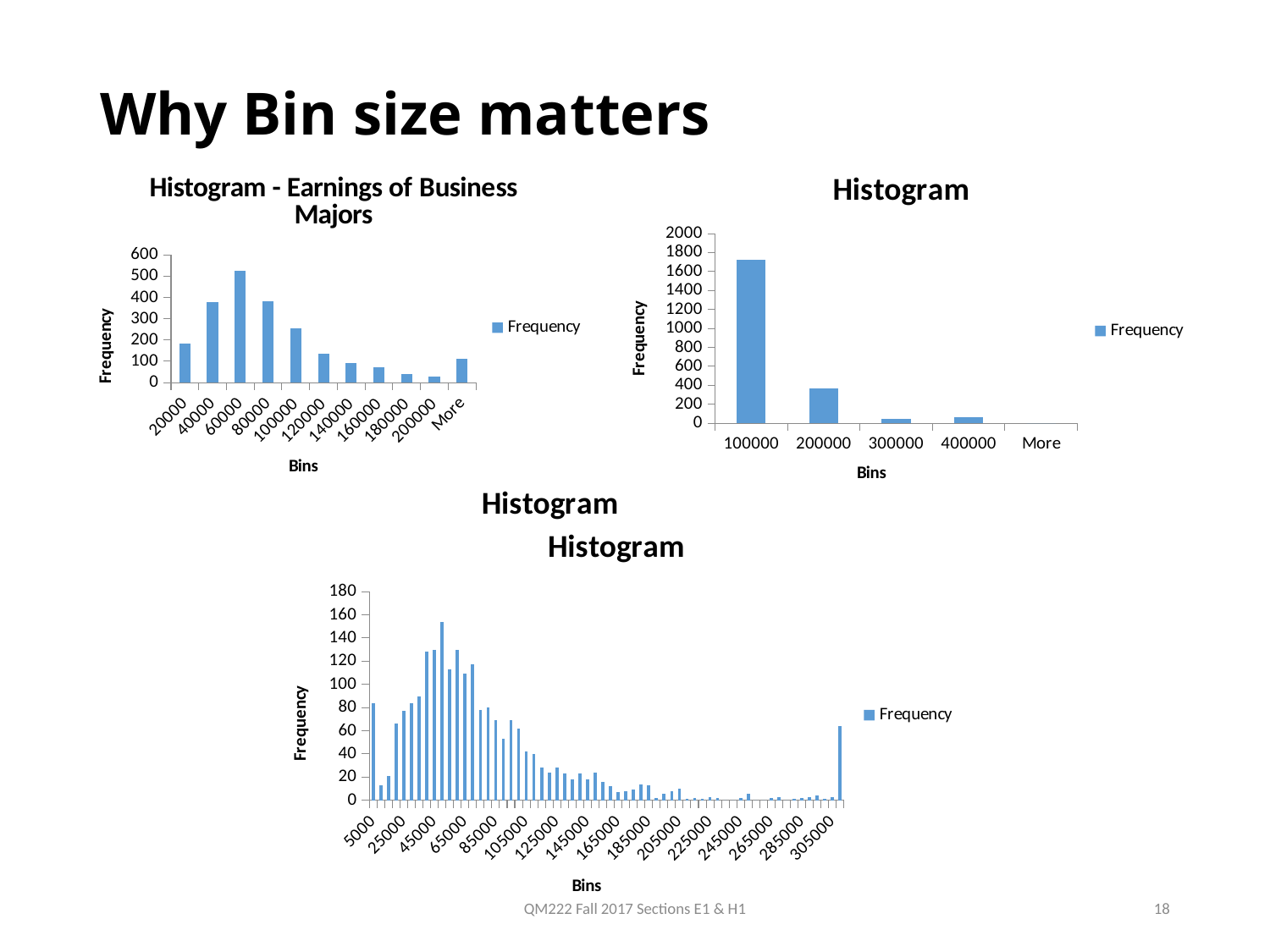
In the top-right chart titled 'Histogram', is the frequency for the 100000 bin greater or less than 1600? greater In the chart titled 'Histogram - Earnings of Business Majors', which bin has the highest frequency? 60000 In the top-right chart titled 'Histogram', how many bins are shown on the x axis? 5 How many series does the legend of the bottom chart titled 'Histogram' list? 1 In the top-right chart titled 'Histogram', which bin has the highest frequency? 100000 In the chart titled 'Histogram - Earnings of Business Majors', is the frequency for the 20000 bin greater or less than 200? less In the top-right chart titled 'Histogram', which bin has the larger frequency, 200000 or 300000? 200000 In the top-right chart titled 'Histogram', is the frequency for the 200000 bin greater or less than 400? less In the chart titled 'Histogram - Earnings of Business Majors', which bin has the larger frequency, 40000 or 100000? 40000 What kind of chart is the bottom chart titled 'Histogram'? bar chart In the chart titled 'Histogram - Earnings of Business Majors', how many bins are shown on the x axis? 11